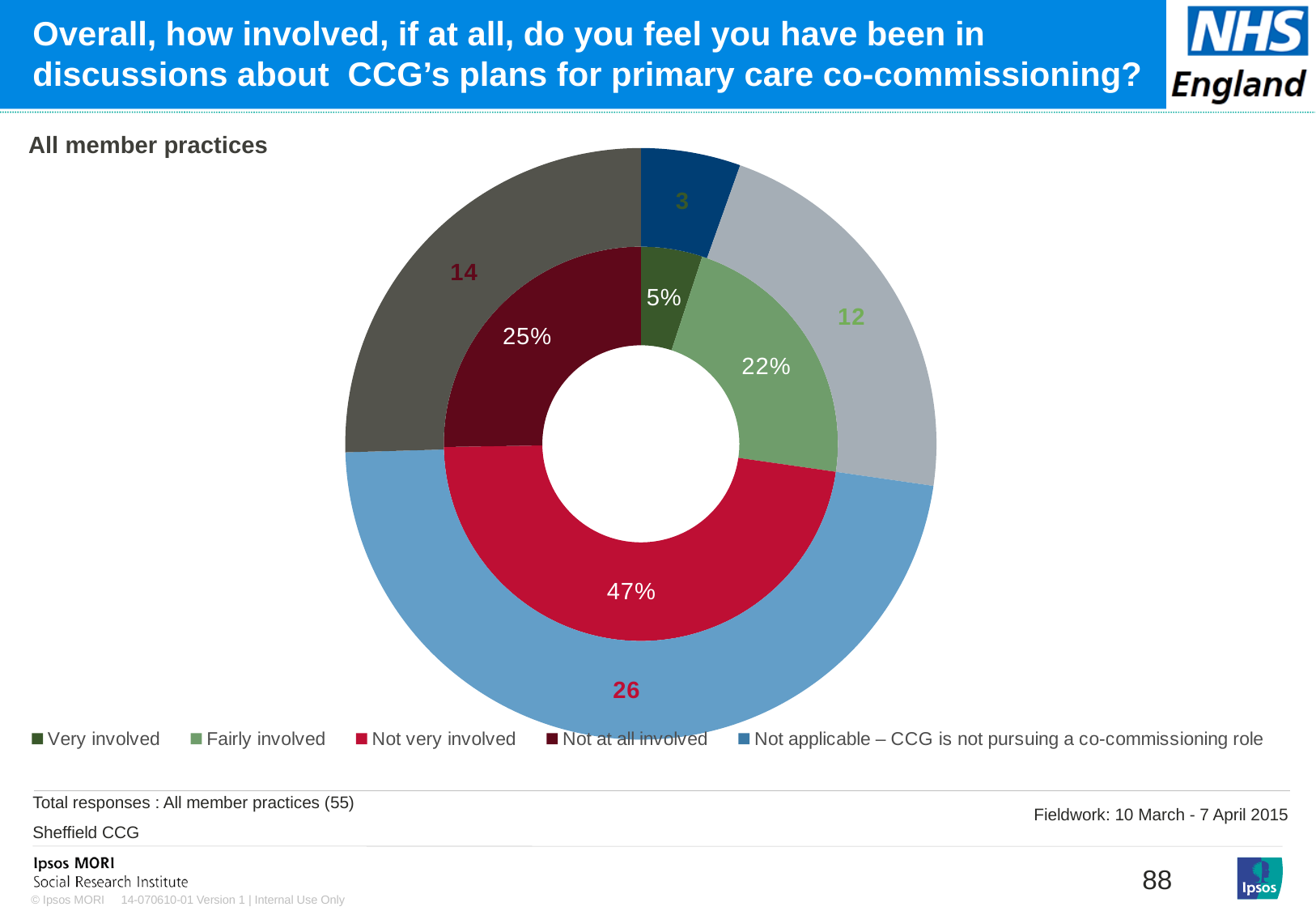
What percentage of member practices said they were 'Not very involved'? 47% What percentage of member practices said they were 'Not at all involved'? 25% How many member practices said they were 'Not very involved', according to the outer ring? 26 What percentage of member practices said they were 'Very involved'? 5% How many member practices said they were 'Not at all involved', according to the outer ring? 14 Which response category has the smallest share of the chart? Very involved Which response category has the largest share of the chart? Not very involved How many response categories does the legend list? 5 What percentage of member practices said they were 'Fairly involved'? 22% What is the difference in percentage points between 'Not very involved' and 'Not at all involved'? 22 percentage points What kind of chart is shown on the slide? Doughnut chart Which is larger: the share for 'Fairly involved' or the share for 'Not at all involved'? Not at all involved